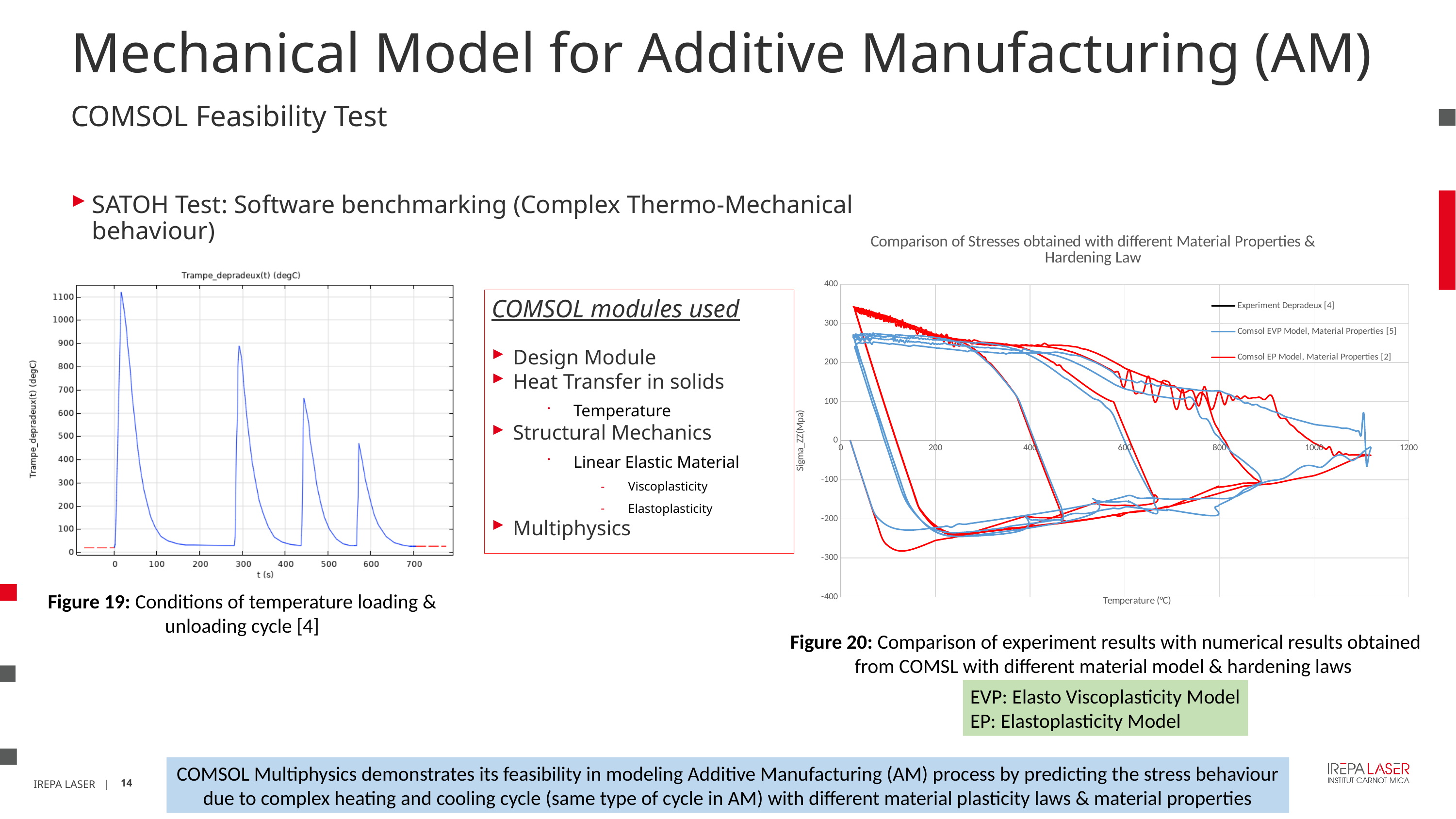
In Figure 19 (the left chart), how many temperature peaks does the curve show? 4 What kind of chart is Figure 20 (the right chart)? line chart In Figure 20 (the right chart), is the highest stress reached by the Comsol EP Model curve greater or less than 300 Mpa? greater In Figure 19 (the left chart), do the successive temperature peaks rise or fall as time increases? fall In Figure 20 (the right chart), is the lowest stress reached by the Comsol EP Model curve greater or less than -200 Mpa? less What is the title of the chart in Figure 20 (the right chart)? Comparison of Stresses obtained with different Material Properties & Hardening Law In Figure 19 (the left chart), is the first temperature peak greater or less than 1000 degC? greater In Figure 20 (the right chart), what is the label of the x axis? Temperature (°C) What kind of chart is Figure 19 (the left chart)? line chart How many series does the legend of Figure 20 (the right chart) list? 3 In Figure 19 (the left chart), what is the label of the x axis? t (s)